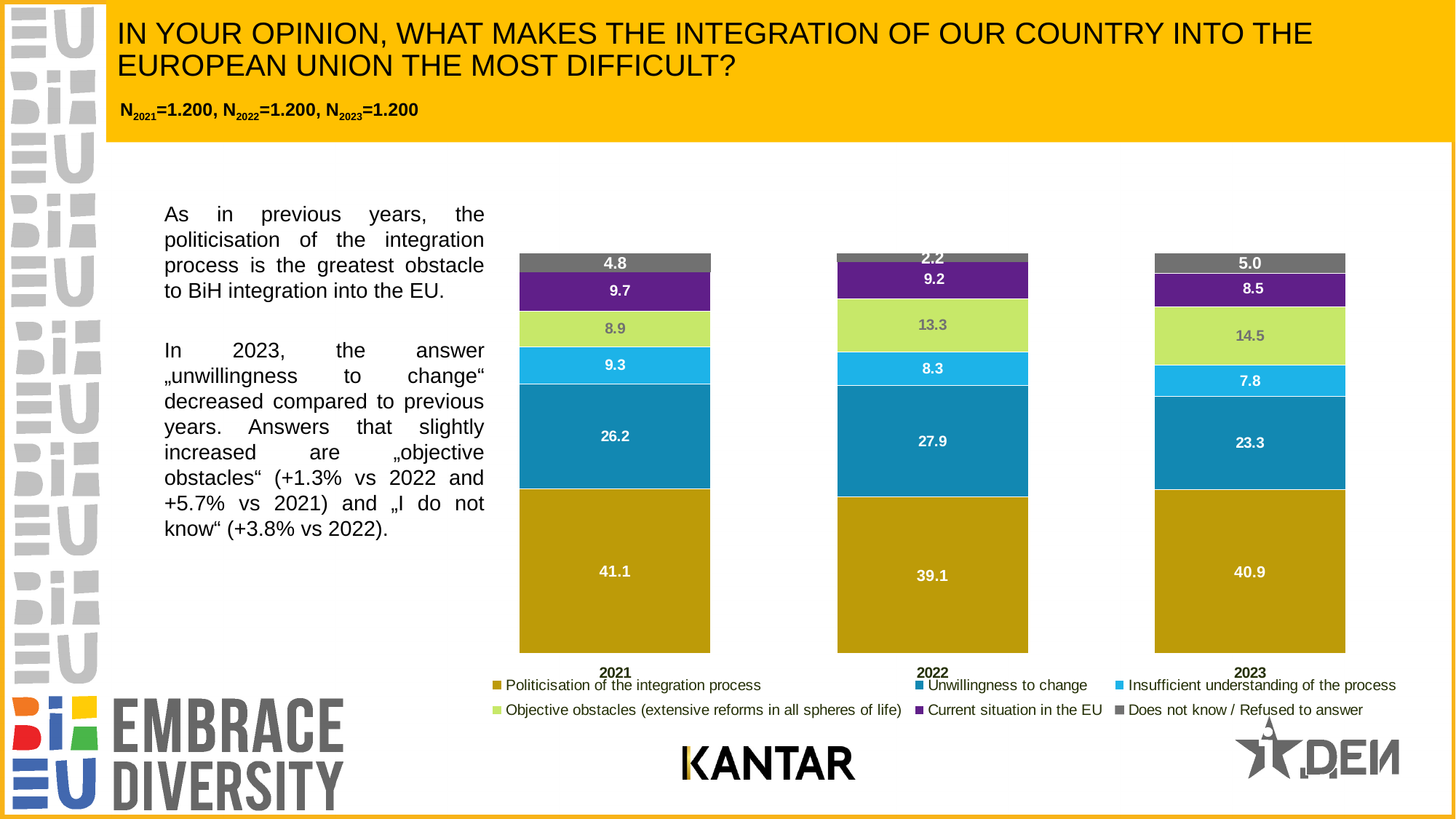
What is the total of the stacked bar for 2022? 100.0 In which year is the value for "Does not know / Refused to answer" lowest? 2022 What is the value for "Unwillingness to change" in 2022? 27.9 What is the value for "Does not know / Refused to answer" in 2021? 4.8 What is the difference between the "Unwillingness to change" values for 2022 and 2023? 4.6 What kind of chart is shown on the slide? Stacked bar chart In which year is the value for "Objective obstacles (extensive reforms in all spheres of life)" highest? 2023 How many years (bars) are shown on the x axis? 3 What is the value for "Politicisation of the integration process" in 2023? 40.9 How many series does the legend list? 6 Which is larger: "Insufficient understanding of the process" in 2021 or in 2023? 2021 Does the value for "Unwillingness to change" rise or fall from 2022 to 2023? Fall